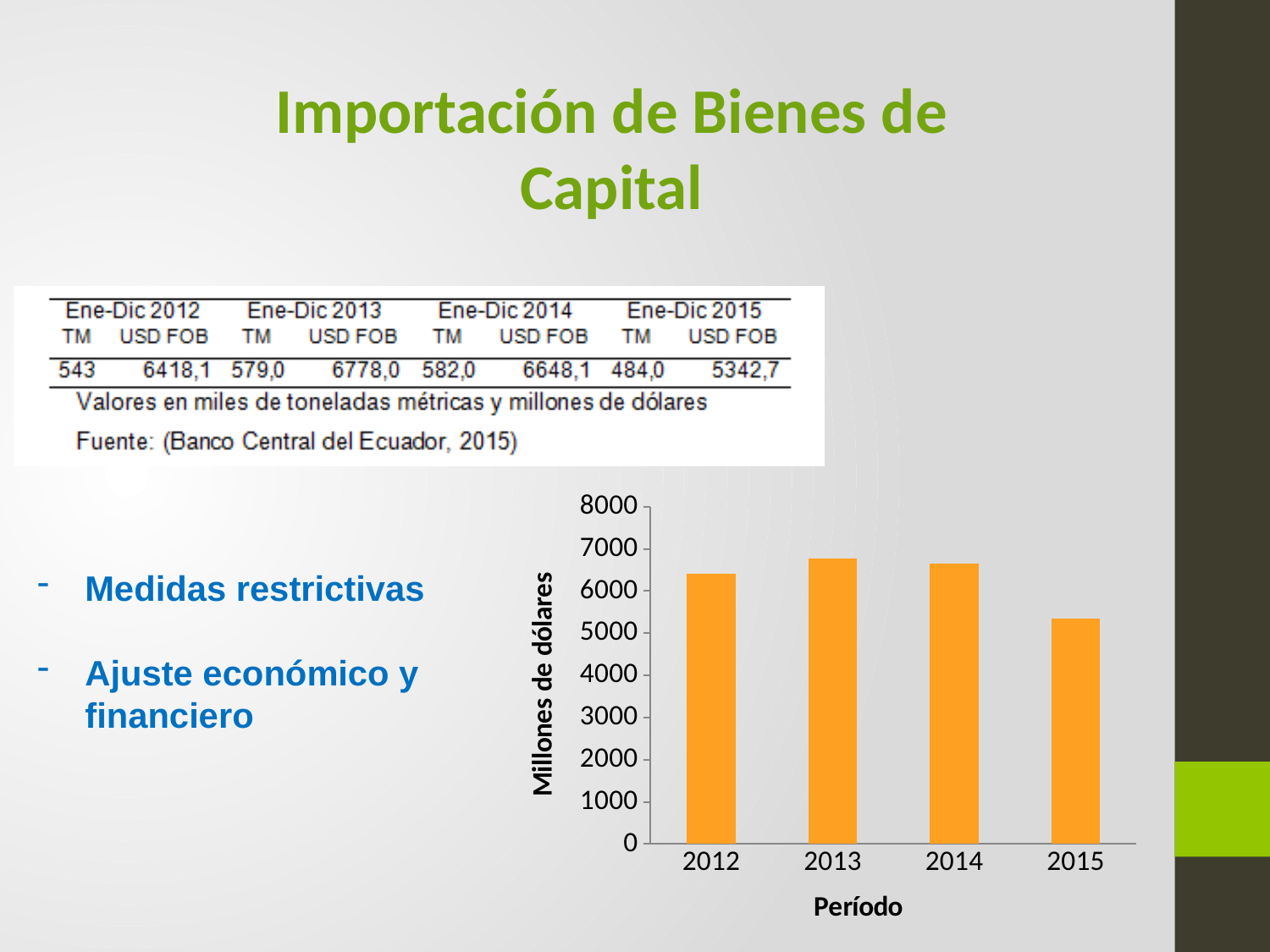
Which is larger, the value for 2012 or the value for 2015? 2012 What is the title of the horizontal axis of the chart? Período Do the values rise or fall from 2013 to 2015? fall Is the value for 2013 greater or less than 7000? less Is the value for 2015 greater or less than 5000? greater Is the value for 2015 greater or less than 6000? less What kind of chart is shown on the slide? bar chart How many years (bars) are shown on the chart? 4 What is the title of the vertical axis of the chart? Millones de dólares Which year has the lowest value on the chart? 2015